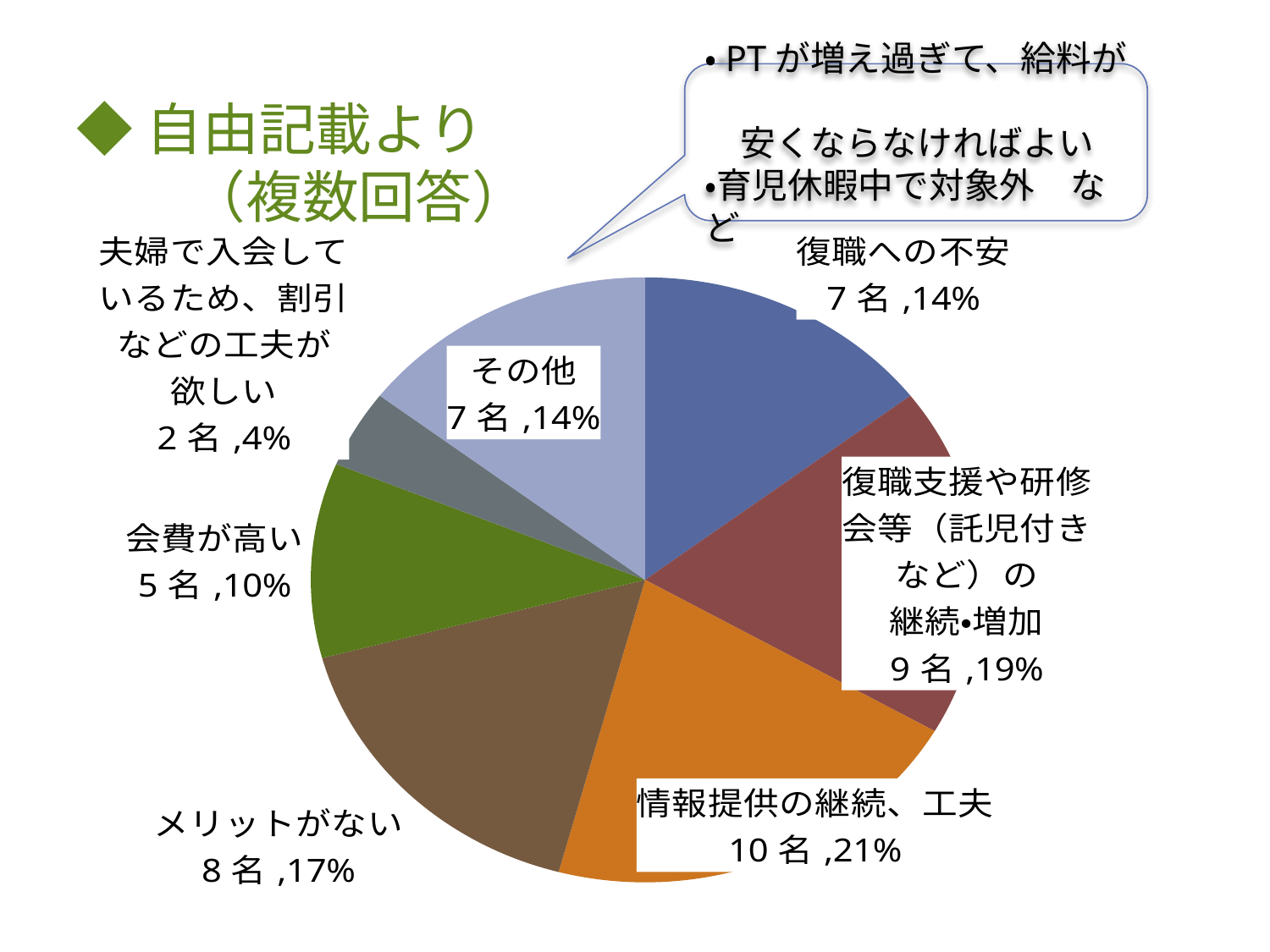
How many slices does the pie chart have? 7 What kind of chart is shown on the slide? pie chart What percentage share is shown for 復職支援や研修会等（託児付きなど）の継続•増加? 19% Which category has the largest slice of the pie? 情報提供の継続、工夫 What percentage share is shown for メリットがない? 17% How many respondents are shown for 情報提供の継続、工夫? 10名 How many respondents are shown for 会費が高い? 5名 What is the title of the slide above the chart? 自由記載より（複数回答） What percentage share is shown for その他? 14% Which has more respondents, メリットがない or 復職への不安? メリットがない Which category has the smallest slice of the pie? 夫婦で入会しているため、割引などの工夫が欲しい What is the difference in number of respondents between 情報提供の継続、工夫 and 会費が高い? 5名